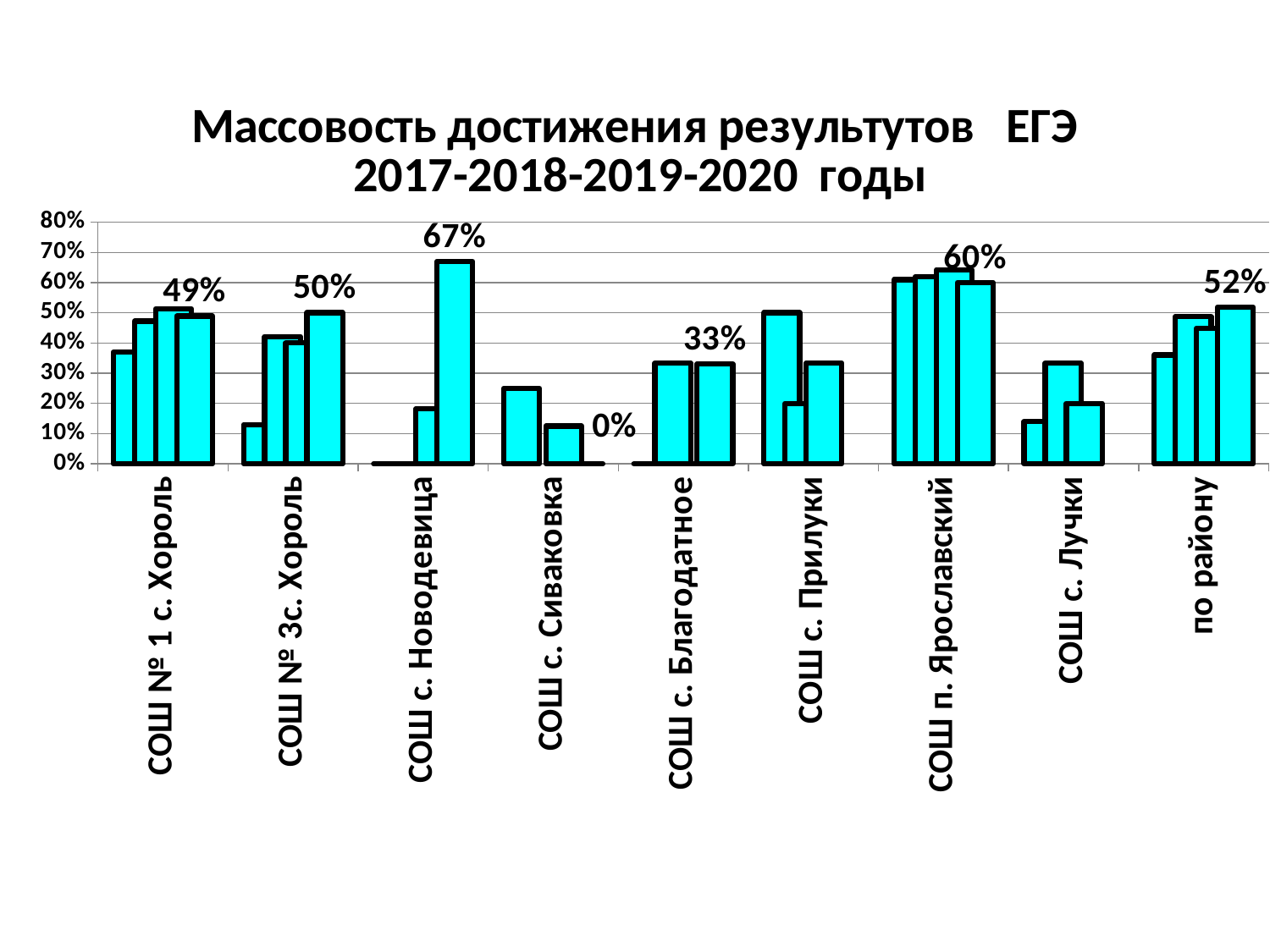
What value is labeled for СОШ с. Новодевица? 67% What type of chart is shown on the slide? Bar chart Which category has the lowest labeled value? СОШ с. Сиваковка What value is labeled for СОШ п. Ярославский? 60% Is the tallest bar for СОШ с. Лучки greater or less than 40%? less Which labeled value is larger: СОШ п. Ярославский or по району? СОШ п. Ярославский Which category has the highest labeled value? СОШ с. Новодевица What value is labeled for СОШ с. Сиваковка? 0% What value is labeled for СОШ № 1 с. Хороль? 49% What is the difference between the labeled values for СОШ с. Новодевица and СОШ № 1 с. Хороль? 18% How many categories are shown on the x axis? 9 What value is labeled for по району? 52%